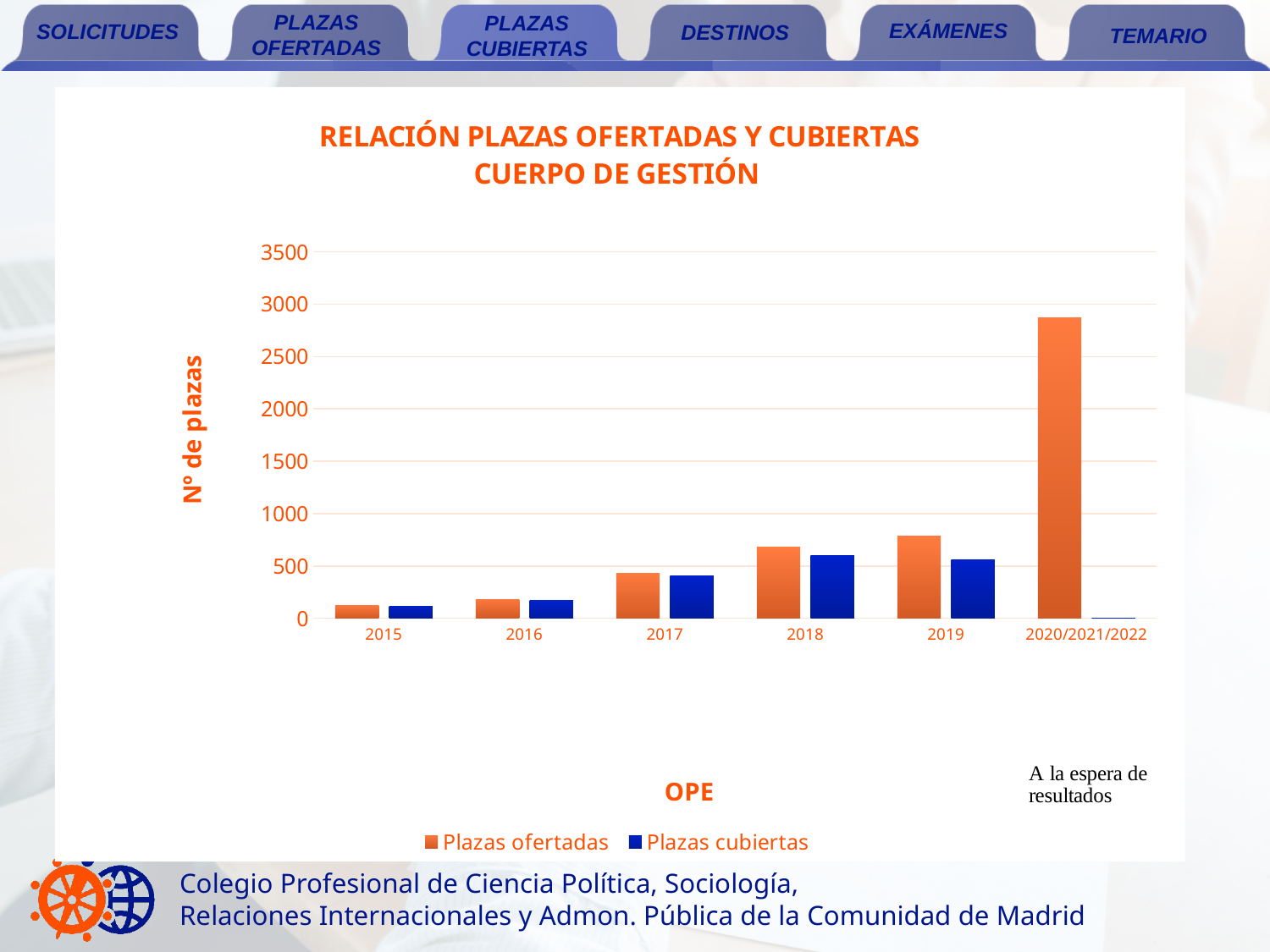
Is the value for Plazas cubiertas in 2018 greater or less than 500? greater In 2019, which is larger: Plazas ofertadas or Plazas cubiertas? Plazas ofertadas What is the title of the vertical axis? Nº de plazas Is the value for Plazas ofertadas in 2019 greater or less than 1000? less Do the values for Plazas ofertadas rise or fall from 2015 to 2019? rise Is the value for Plazas ofertadas in 2020/2021/2022 greater or less than 2500? greater How many series does the legend list? 2 Which category has the highest value for Plazas ofertadas? 2020/2021/2022 What kind of chart is shown on the slide? Bar chart How many categories are shown on the x axis? 6 Which category has the lowest value for Plazas ofertadas? 2015 What is the title of the horizontal axis? OPE